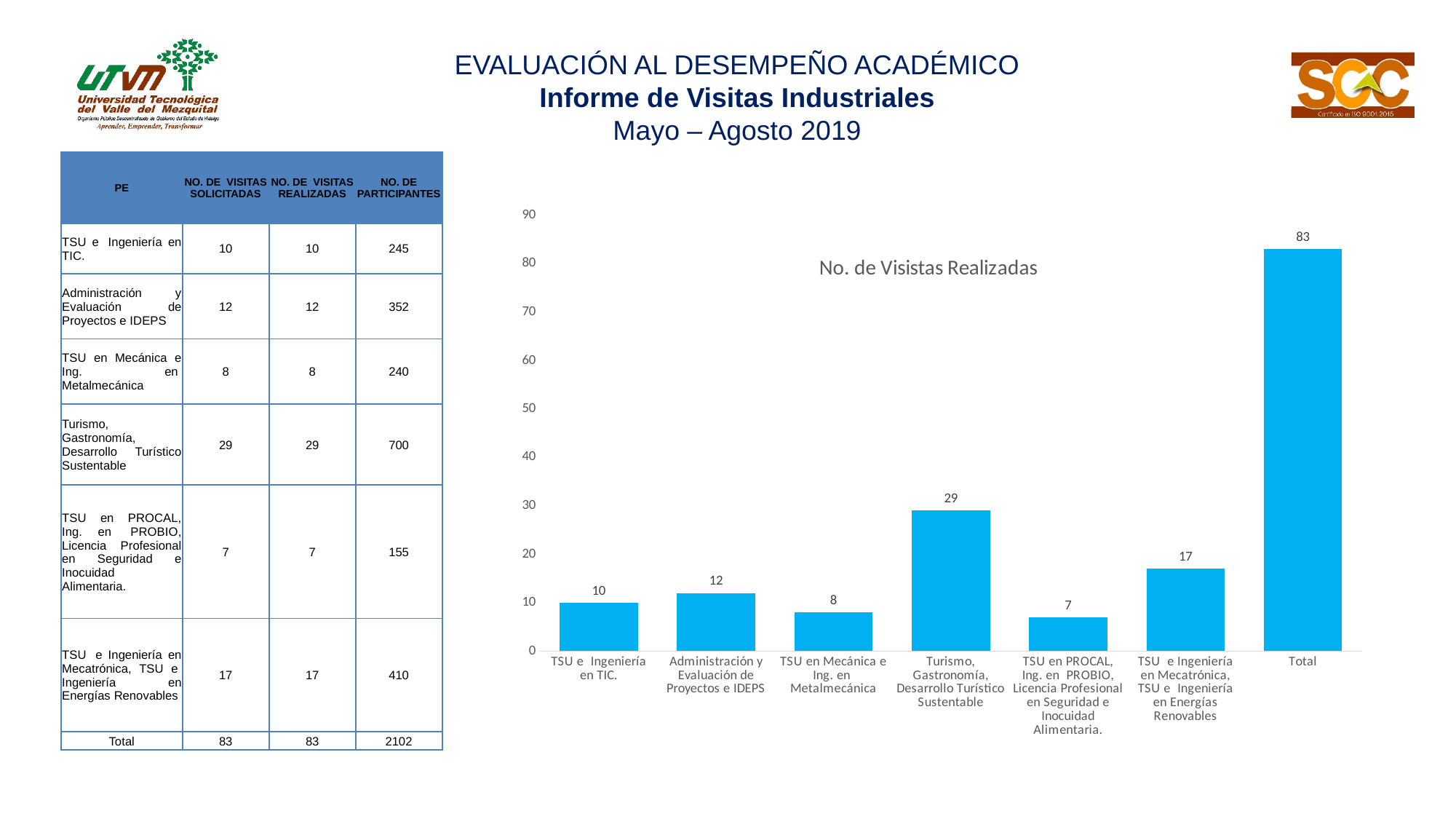
What is the value for 'TSU en Mecánica e Ing. en Metalmecánica' in the chart? 8 How many bars are plotted in the chart, including the Total bar? 7 What type of chart is shown on the slide? bar chart What is the value of the 'Total' bar in the chart? 83 Is the value for 'TSU e Ingeniería en Mecatrónica, TSU e Ingeniería en Energías Renovables' greater or less than 20? less What is the difference between the values for 'Turismo, Gastronomía, Desarrollo Turístico Sustentable' and 'TSU e Ingeniería en Mecatrónica, TSU e Ingeniería en Energías Renovables'? 12 Which has a larger value: 'Administración y Evaluación de Proyectos e IDEPS' or 'TSU en Mecánica e Ing. en Metalmecánica'? Administración y Evaluación de Proyectos e IDEPS Excluding the Total bar, which category has the highest value in the chart? Turismo, Gastronomía, Desarrollo Turístico Sustentable What is the title of the chart? No. de Visistas Realizadas Which category has the lowest value in the chart? TSU en PROCAL, Ing. en PROBIO, Licencia Profesional en Seguridad e Inocuidad Alimentaria. What is the value for 'Turismo, Gastronomía, Desarrollo Turístico Sustentable' in the chart? 29 What is the value for 'TSU e Ingeniería en TIC.' in the chart? 10